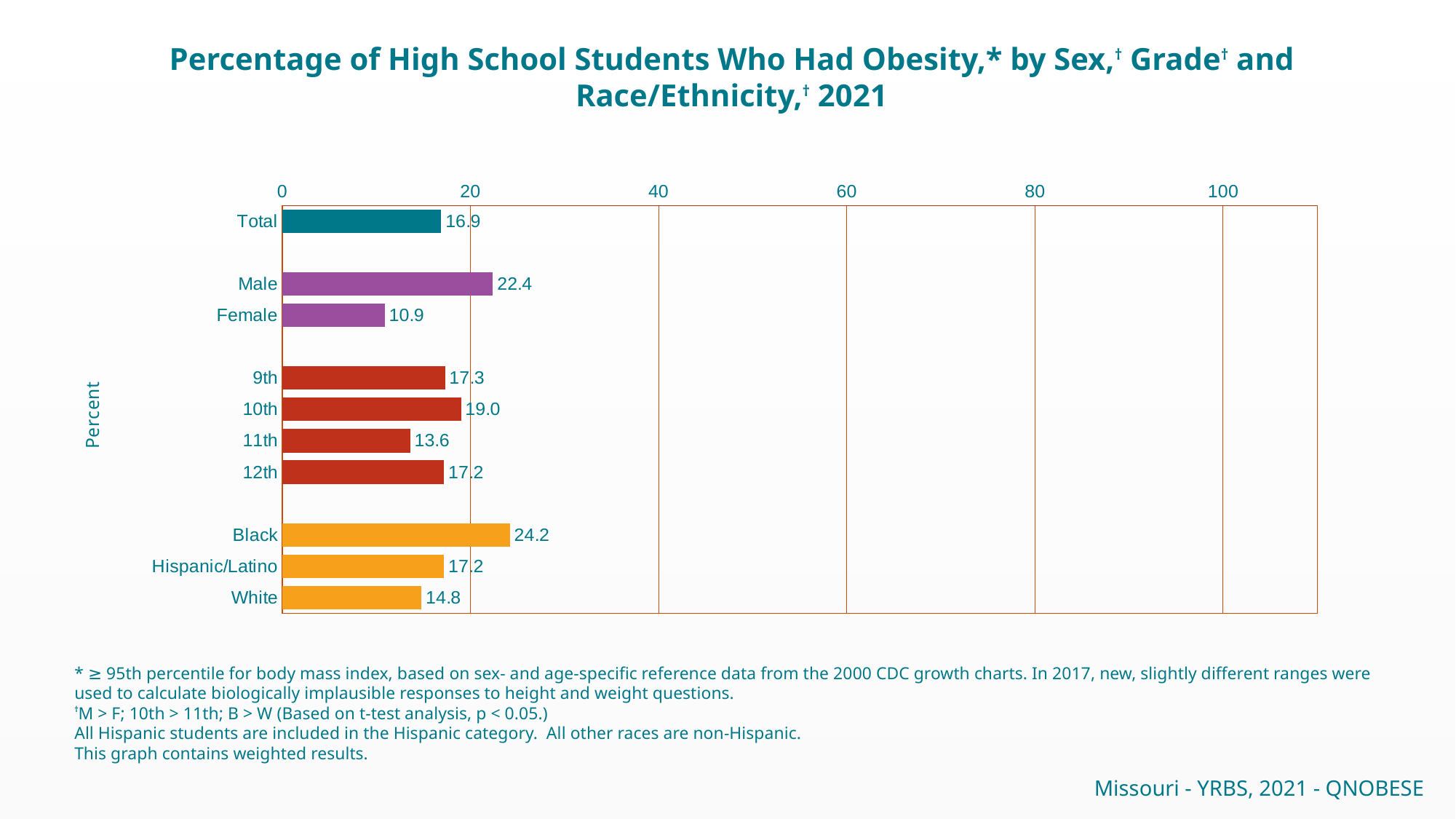
What is the value for Total? 16.9 Which category has the lowest value? Female What is the difference between the Male and Female values? 11.5 How many categories are plotted in the chart? 10 Is the value for 11th grade greater or less than 20? less Which is larger, the value for Black or the value for White? Black What is the value for Female? 10.9 What is the value for 10th grade? 19.0 What is the axis label on the vertical axis? Percent What is the value for Hispanic/Latino? 17.2 What kind of chart is shown? Bar chart Which category has the highest value? Black